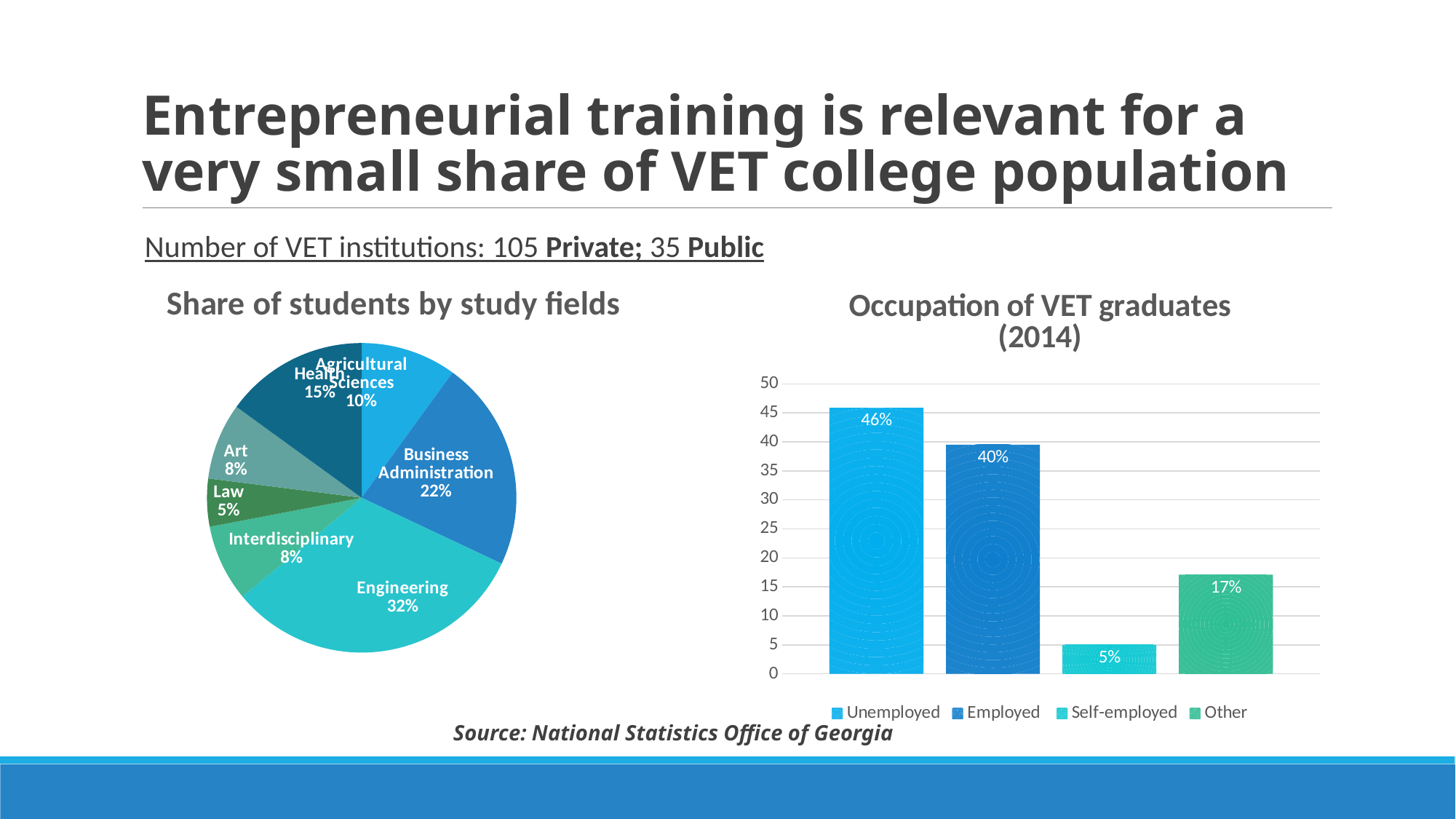
In the 'Occupation of VET graduates (2014)' chart, which category has the highest value? Unemployed In the 'Occupation of VET graduates (2014)' chart, what is the value for Unemployed? 46% In the 'Share of students by study fields' chart, what share of students study Business Administration? 22% In the 'Share of students by study fields' chart, how many study fields are shown? 7 In the 'Share of students by study fields' chart, which study field has the smallest share of students? Law In the 'Share of students by study fields' chart, what share of students study Engineering? 32% In the 'Share of students by study fields' chart, which study field has the largest share of students? Engineering In the 'Occupation of VET graduates (2014)' chart, what is the value for Self-employed? 5% In the 'Share of students by study fields' chart, what is the difference between the Health share and the Agricultural Sciences share? 5% In the 'Occupation of VET graduates (2014)' chart, what is the difference between the Employed and Other values? 23% What kind of chart is 'Share of students by study fields'? Pie chart In the 'Occupation of VET graduates (2014)' chart, how many entries does the legend list? 4